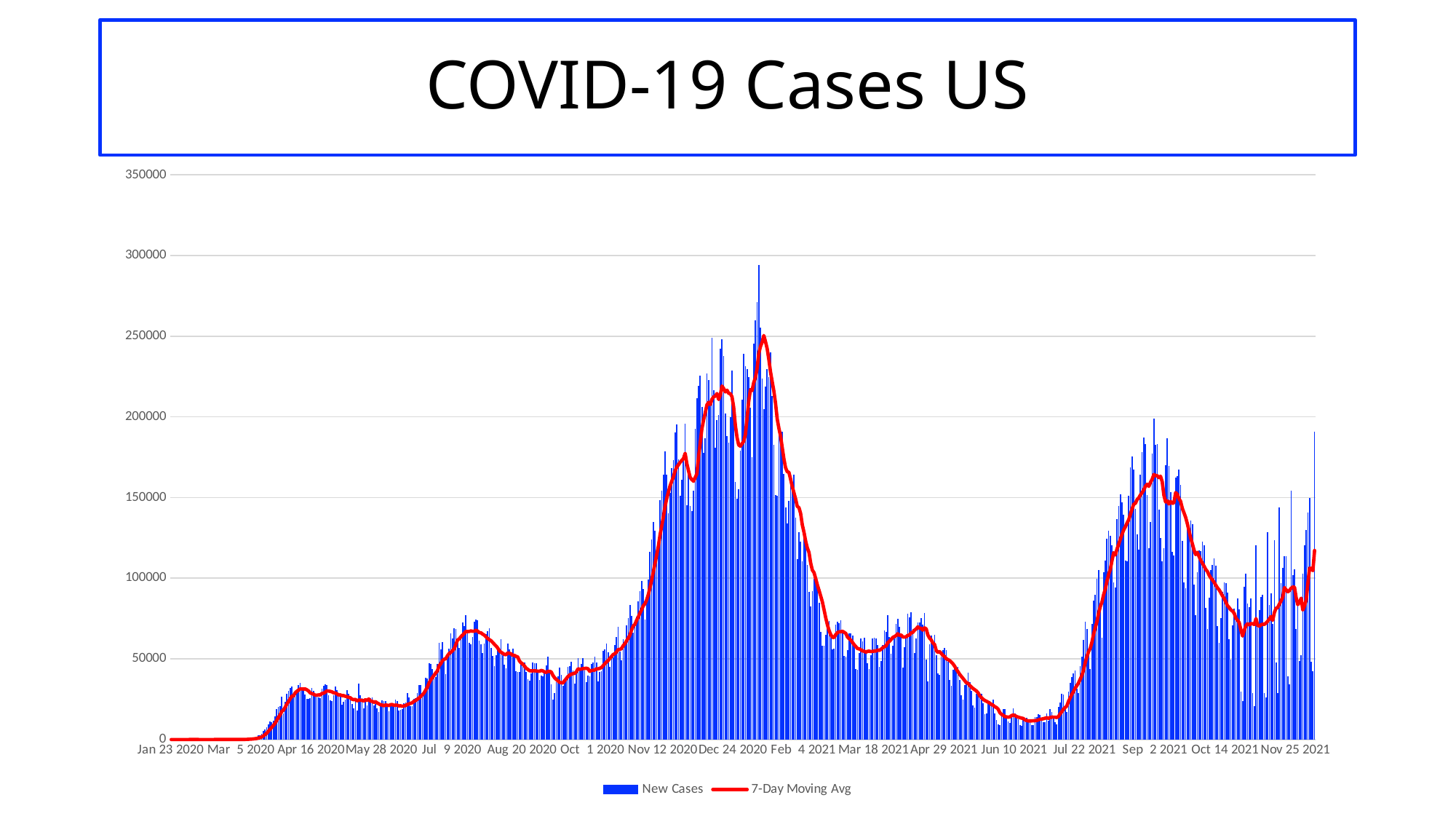
What kind of chart is this? A combined bar and line chart What is the title of the chart? COVID-19 Cases US Is the 7-Day Moving Avg value at Jun 10 2021 greater or less than 50000? less What are the two series named in the legend? New Cases and 7-Day Moving Avg Does the 7-Day Moving Avg rise or fall between Feb 4 2021 and Jun 10 2021? fall Is the peak of the 7-Day Moving Avg line greater or less than 200000? greater What is the highest value shown on the vertical axis? 350000 Is the 7-Day Moving Avg value at Sep 2 2021 greater or less than 100000? greater How many series does the legend list? 2 Does the 7-Day Moving Avg rise or fall between Jul 22 2021 and Sep 2 2021? rise Between which two x-axis labels does the 7-Day Moving Avg reach its highest point? Dec 24 2020 and Feb 4 2021